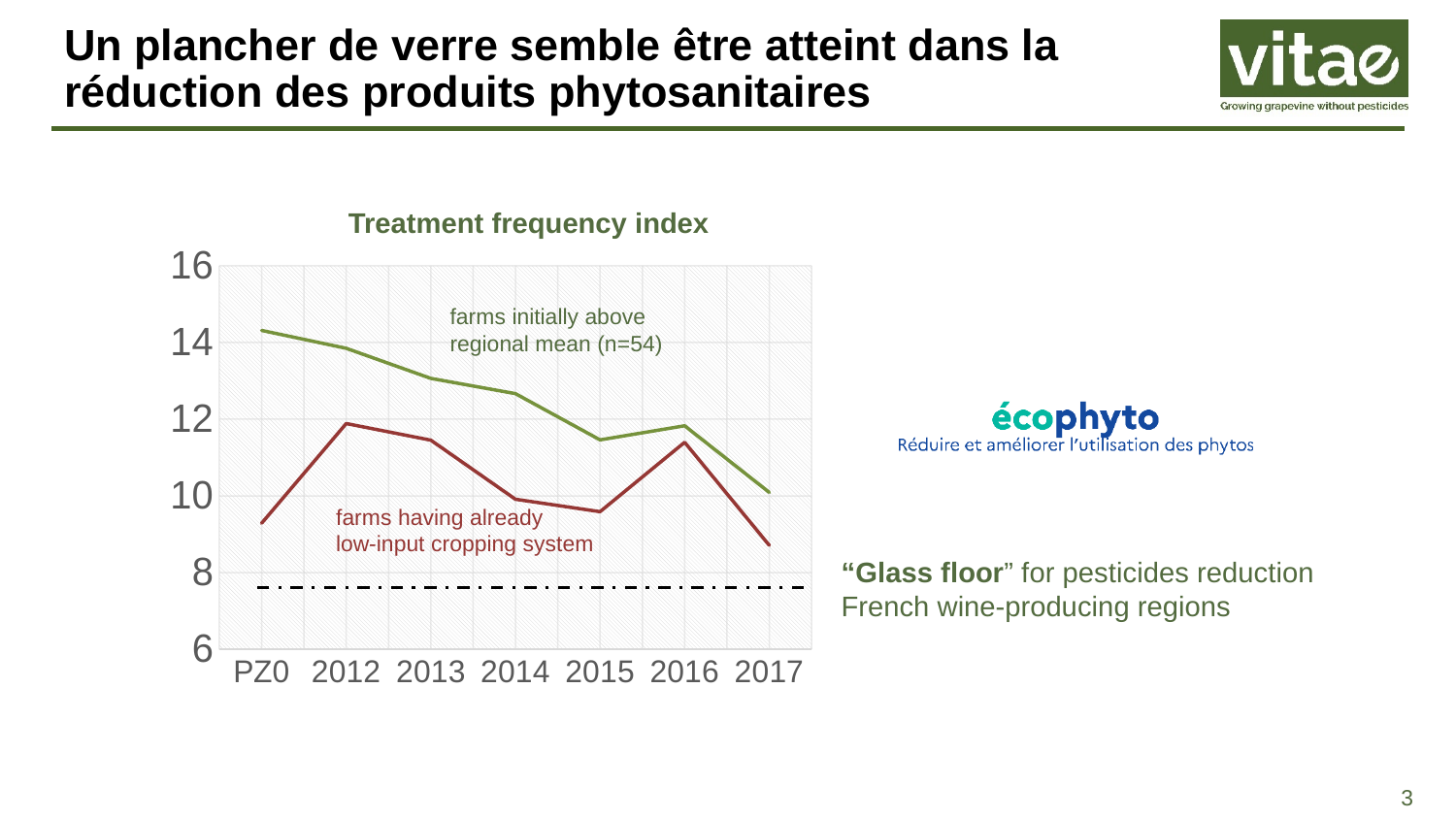
Which series does the green line represent? farms initially above regional mean (n=54) At which x-axis point is the value for farms having already low-input cropping system highest? 2012 At which x-axis point is the value for farms initially above regional mean (n=54) lowest? 2017 Is the value for farms initially above regional mean (n=54) at PZ0 greater or less than 14? greater Does the line for farms initially above regional mean (n=54) generally rise or fall from PZ0 to 2017? fall Is the value for farms having already low-input cropping system at PZ0 greater or less than 10? less What is the title of the chart? Treatment frequency index How many points are plotted along the x axis for each line? 7 At which x-axis point is the value for farms having already low-input cropping system lowest? 2017 In 2014, which series has the larger value: farms initially above regional mean (n=54) or farms having already low-input cropping system? farms initially above regional mean (n=54) At which x-axis point is the value for farms initially above regional mean (n=54) highest? PZ0 What kind of chart is shown on the slide? line chart